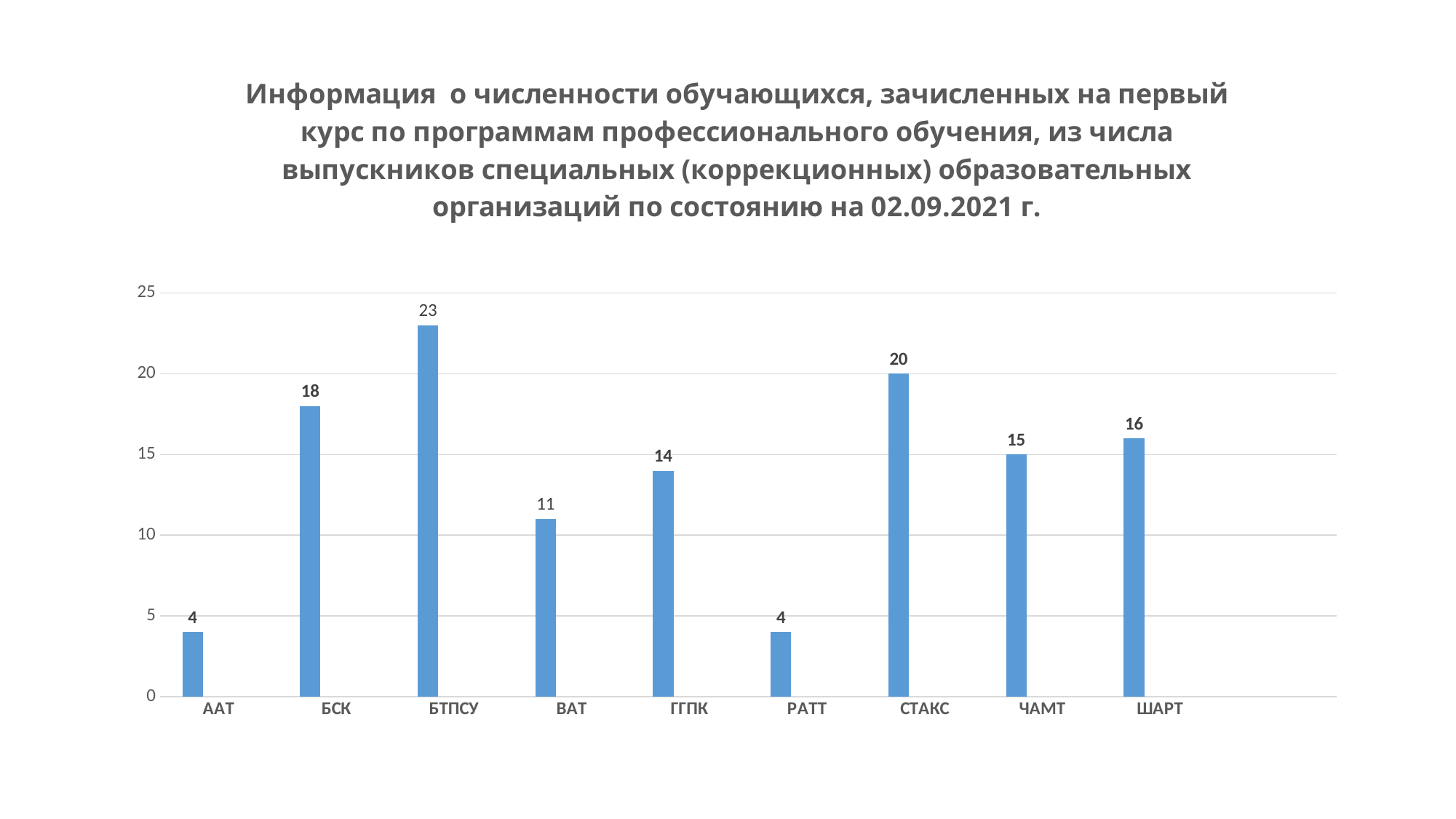
Which category has the highest value? БТПСУ What is the date stated in the chart title? 02.09.2021 г. Which categories share the lowest value? ААТ and РАТТ What is the difference between the values for БТПСУ and БСК? 5 What is the value for ВАТ? 11 What kind of chart is shown on the slide? Bar chart What is the difference between the values for ШАРТ and ЧАМТ? 1 How many categories are shown on the x axis? 9 Is the value for СТАКС greater or less than 15? greater What is the value for БТПСУ? 23 Which is larger, the value for ГГПК or the value for ВАТ? ГГПК What is the value for СТАКС? 20